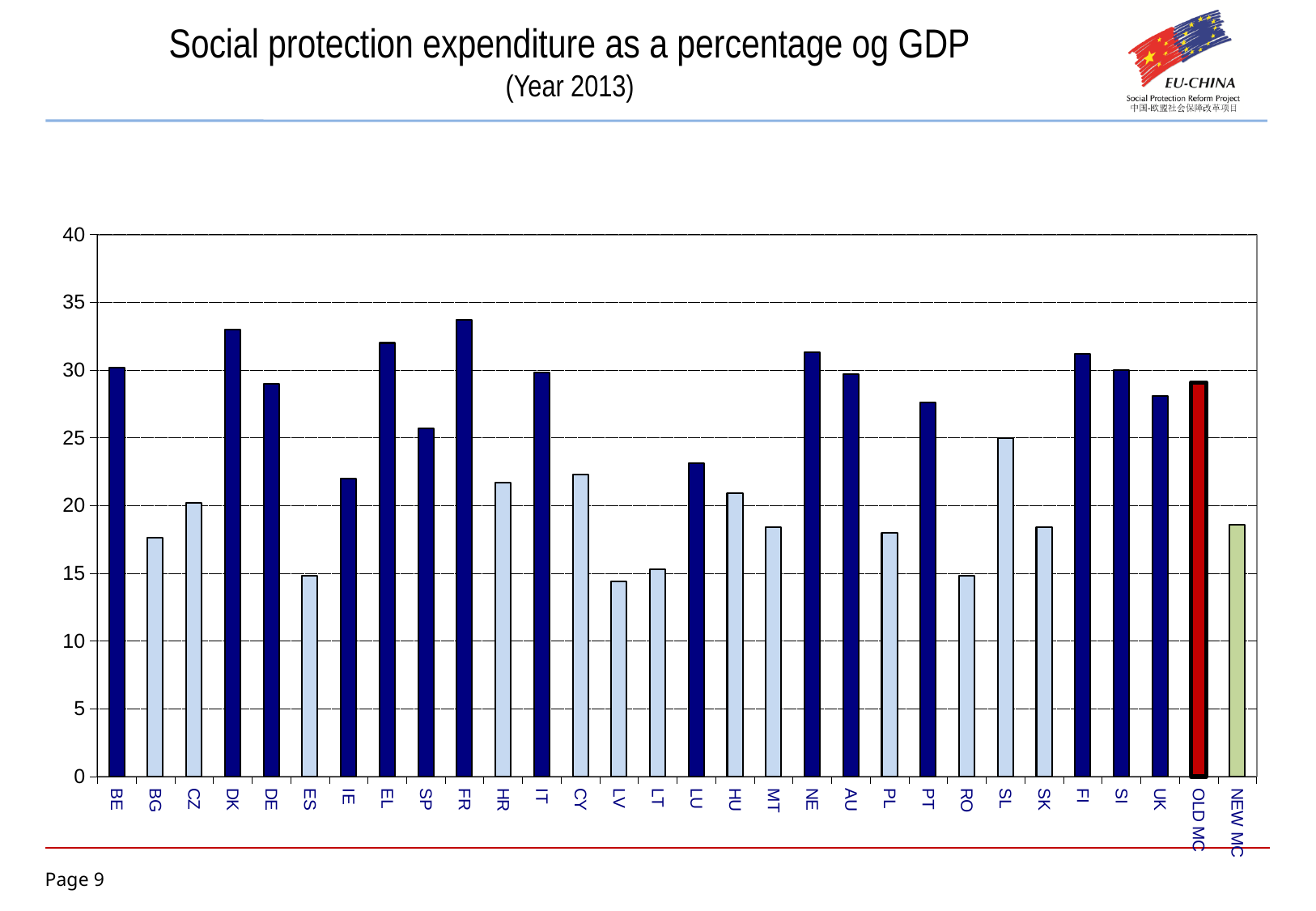
Is the value for DK greater or less than 30? greater Is the value for BG greater or less than 20? less Which is larger, the value for OLD MC or the value for NEW MC? OLD MC What is the title of the chart on the slide? Social protection expenditure as a percentage og GDP (Year 2013) Is the value for NEW MC greater or less than 20? less What kind of chart is shown on the slide? bar chart Which is larger, the value for CY or the value for LV? CY Which category has the highest value in the chart? FR How many categories are shown on the x axis of the chart? 30 Which is larger, the value for DK or the value for DE? DK